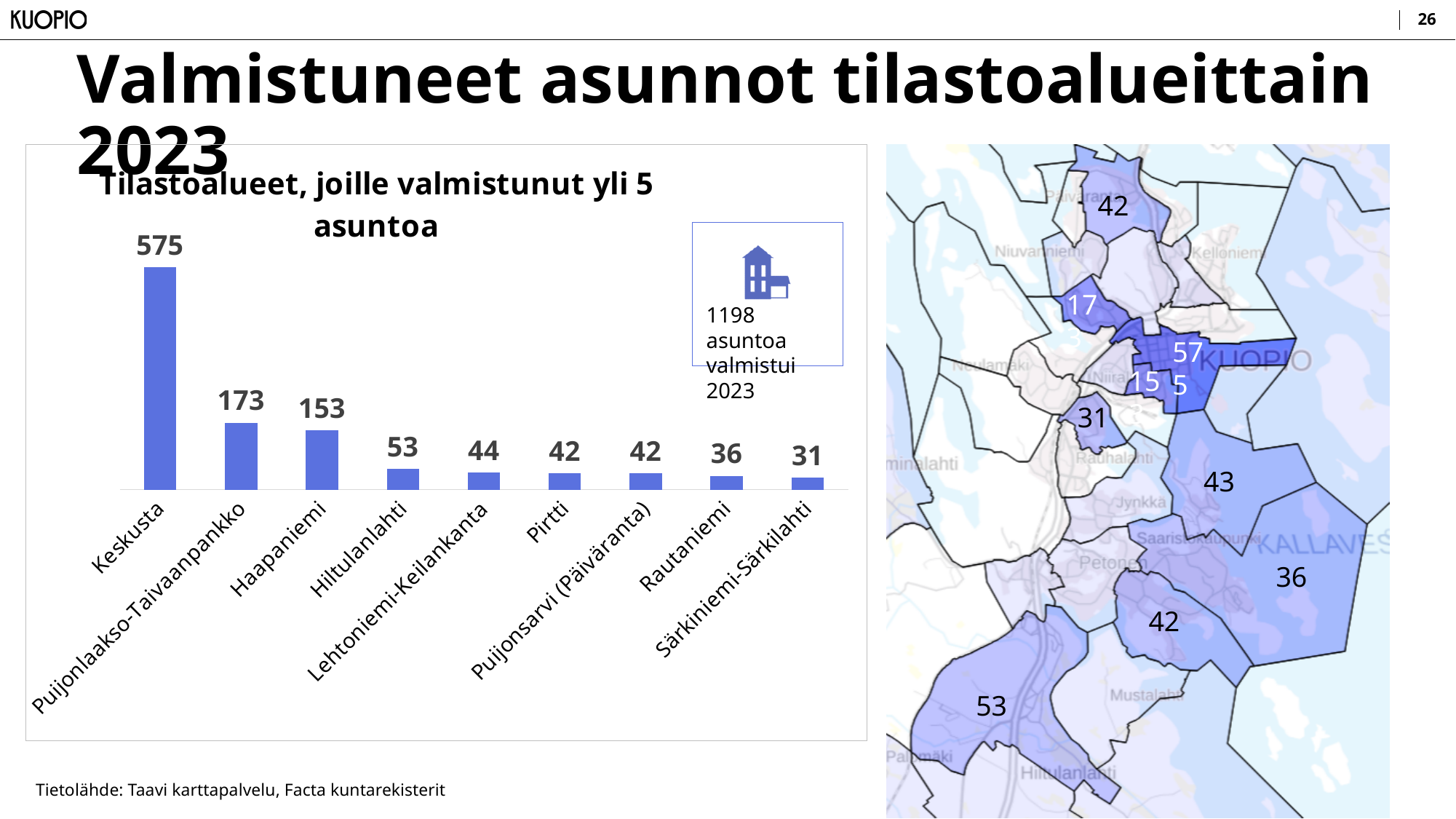
Do the values in the bar chart rise or fall from left to right? Fall What is the value for Rautaniemi in the bar chart? 36 What is the value for Haapaniemi in the bar chart? 153 What is the difference between the values for Hiltulanlahti and Lehtoniemi-Keilankanta? 9 What is the title of the bar chart? Tilastoalueet, joille valmistunut yli 5 asuntoa What is the difference between the values for Keskusta and Puijonlaakso-Taivaanpankko? 402 Which category has the highest value in the bar chart? Keskusta What kind of chart is shown on the left of the slide? Bar chart How many categories are shown in the bar chart? 9 Which category has the lowest value in the bar chart? Särkiniemi-Särkilahti Which is larger, the value for Puijonlaakso-Taivaanpankko or the value for Haapaniemi? Puijonlaakso-Taivaanpankko What is the value for Keskusta in the bar chart? 575